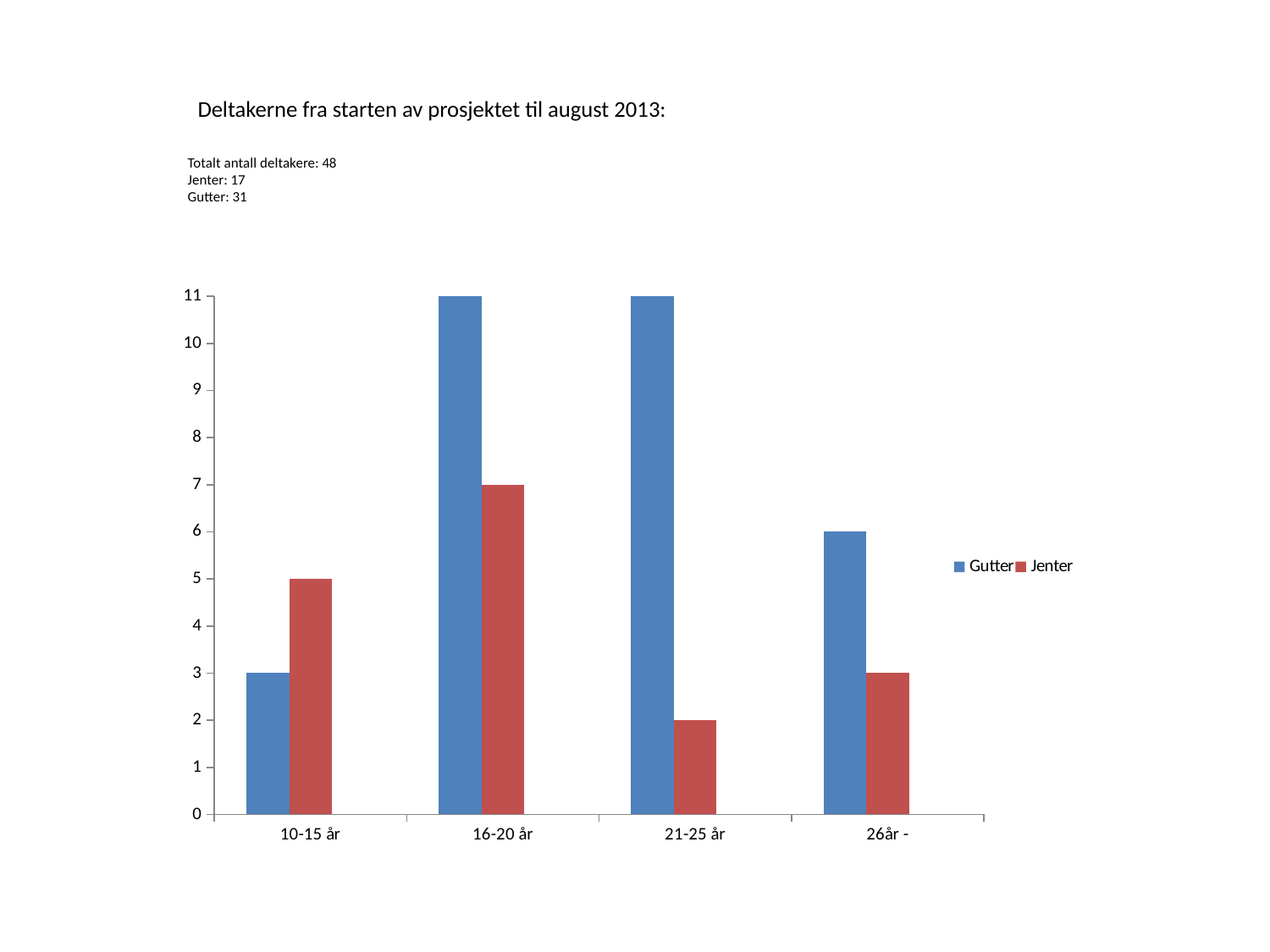
In the 10-15 år category, which series has the larger value, Gutter or Jenter? Jenter What kind of chart is shown on the slide? bar chart Which age category has the highest value for Jenter? 16-20 år Which age category has the lowest value for Gutter? 10-15 år What is the difference between Gutter and Jenter in the 16-20 år category? 4 How many series does the legend list? 2 What is the value for Jenter in the 21-25 år category? 2 Is the value for Gutter in the 21-25 år category greater or less than 10? greater How many age categories are shown on the x axis? 4 What is the value for Gutter in the 26år - category? 6 What is the value for Gutter in the 16-20 år category? 11 What is the value for Jenter in the 10-15 år category? 5